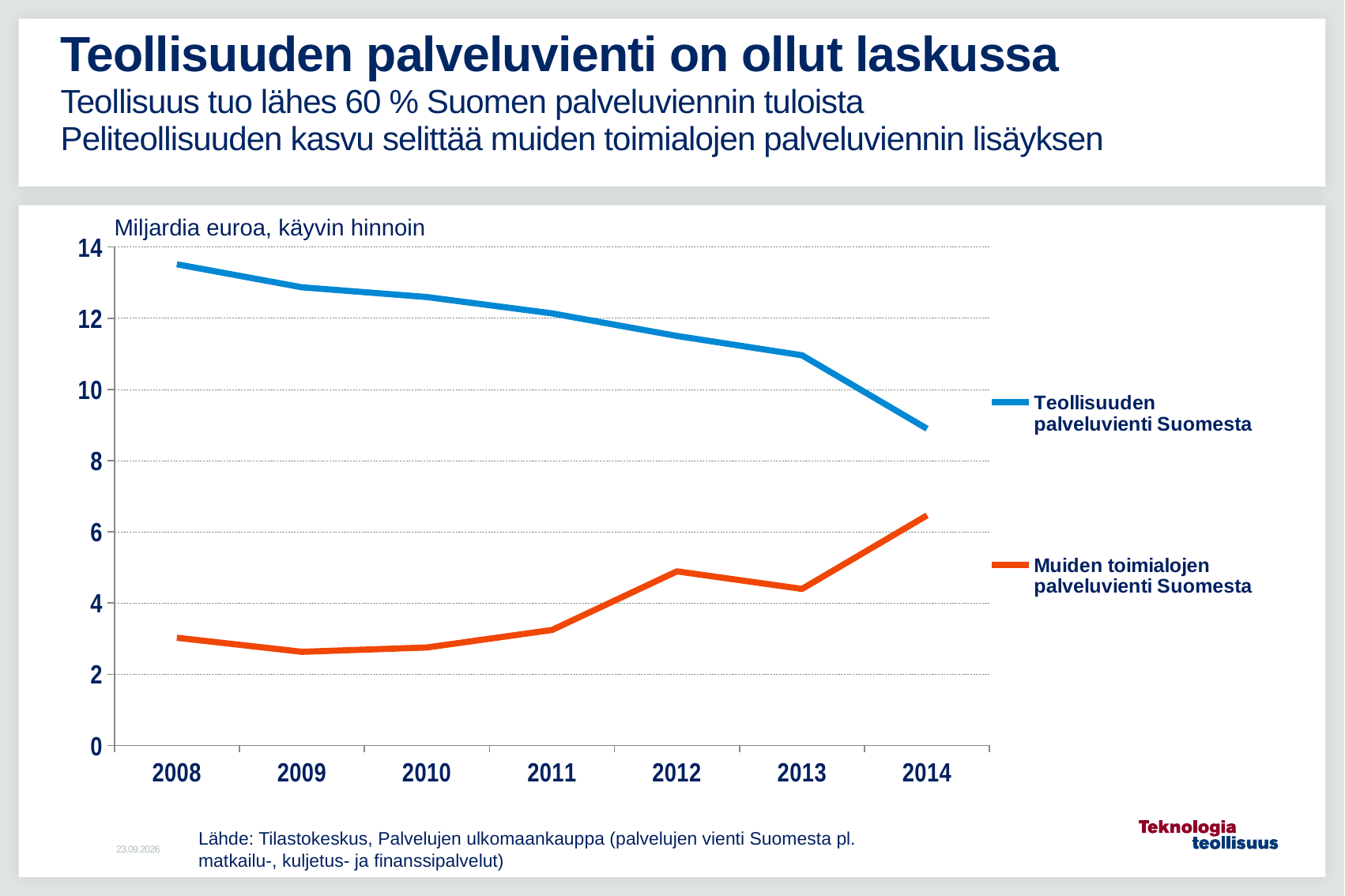
Is the value for Muiden toimialojen palveluvienti Suomesta in 2012 greater or less than 4? greater Does the line for Muiden toimialojen palveluvienti Suomesta rise or fall overall from 2008 to 2014? rise Does the line for Teollisuuden palveluvienti Suomesta rise or fall from 2008 to 2014? fall How many years are shown on the x axis? 7 Is the value for Teollisuuden palveluvienti Suomesta in 2014 greater or less than 10? less In which year is Muiden toimialojen palveluvienti Suomesta highest? 2014 What kind of chart is shown on the slide? line chart In 2013, which series has the larger value, Teollisuuden palveluvienti Suomesta or Muiden toimialojen palveluvienti Suomesta? Teollisuuden palveluvienti Suomesta How many series does the legend list? 2 In which year is Teollisuuden palveluvienti Suomesta lowest? 2014 In which year is Teollisuuden palveluvienti Suomesta highest? 2008 What unit label is shown above the y axis of the chart? Miljardia euroa, käyvin hinnoin